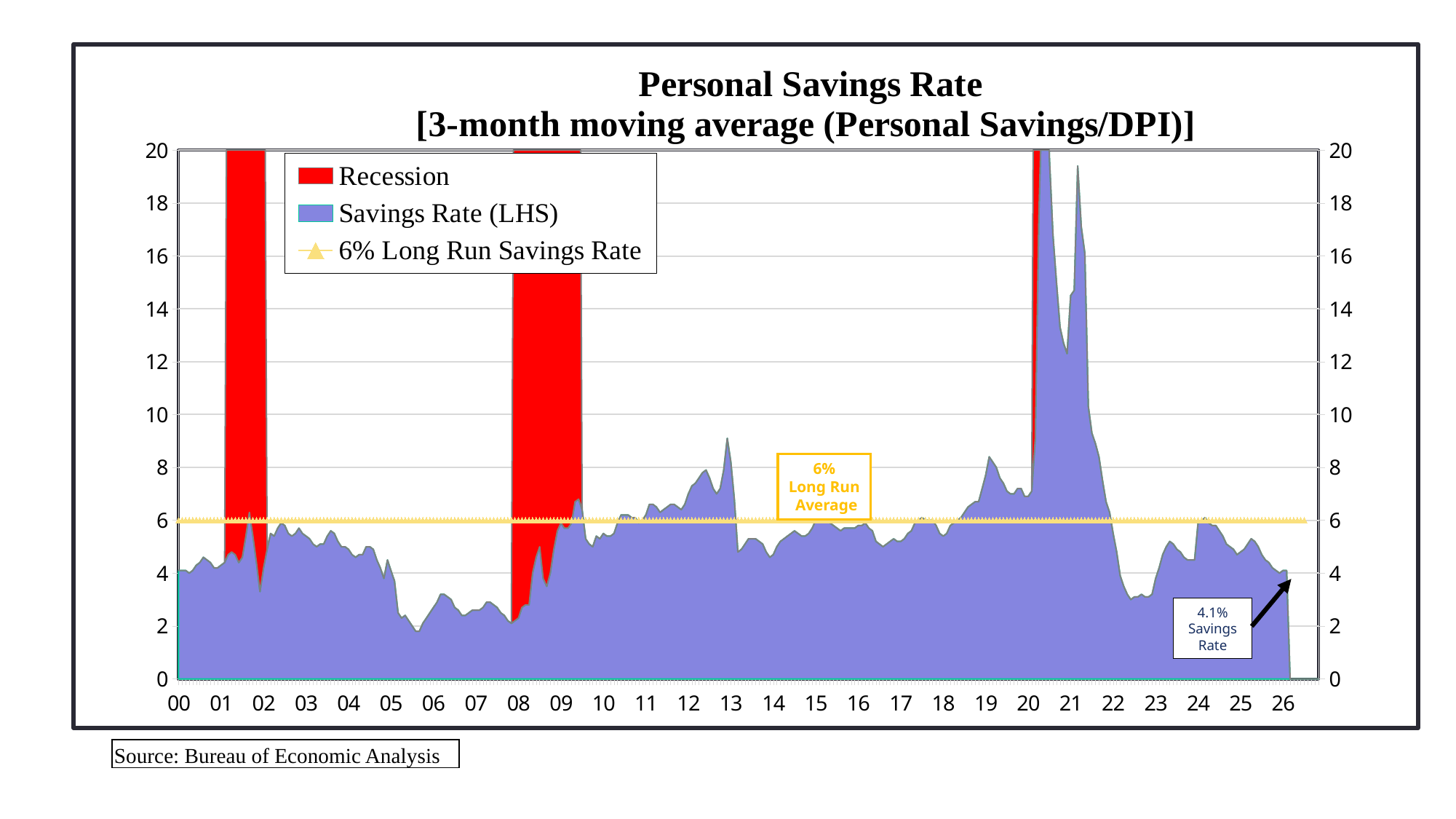
How many series does the legend list? 3 Is the peak savings rate in 2020 greater or less than 16? greater Which is higher, the savings rate peak in 2021 or the peak in 2013? 2021 What is the most recent savings rate labelled on the chart? 4.1% Is the savings rate at the start of 2024 greater or less than 4? greater Is the savings rate in 2006 greater or less than 4? less What is the source cited for the chart? Bureau of Economic Analysis What kind of chart is this? Area chart What is the long run savings rate shown by the horizontal line? 6% How many recession periods are shaded on the chart? 3 What is the title of the chart? Personal Savings Rate [3-month moving average (Personal Savings/DPI)] In which year does the savings rate reach its highest level? 2020